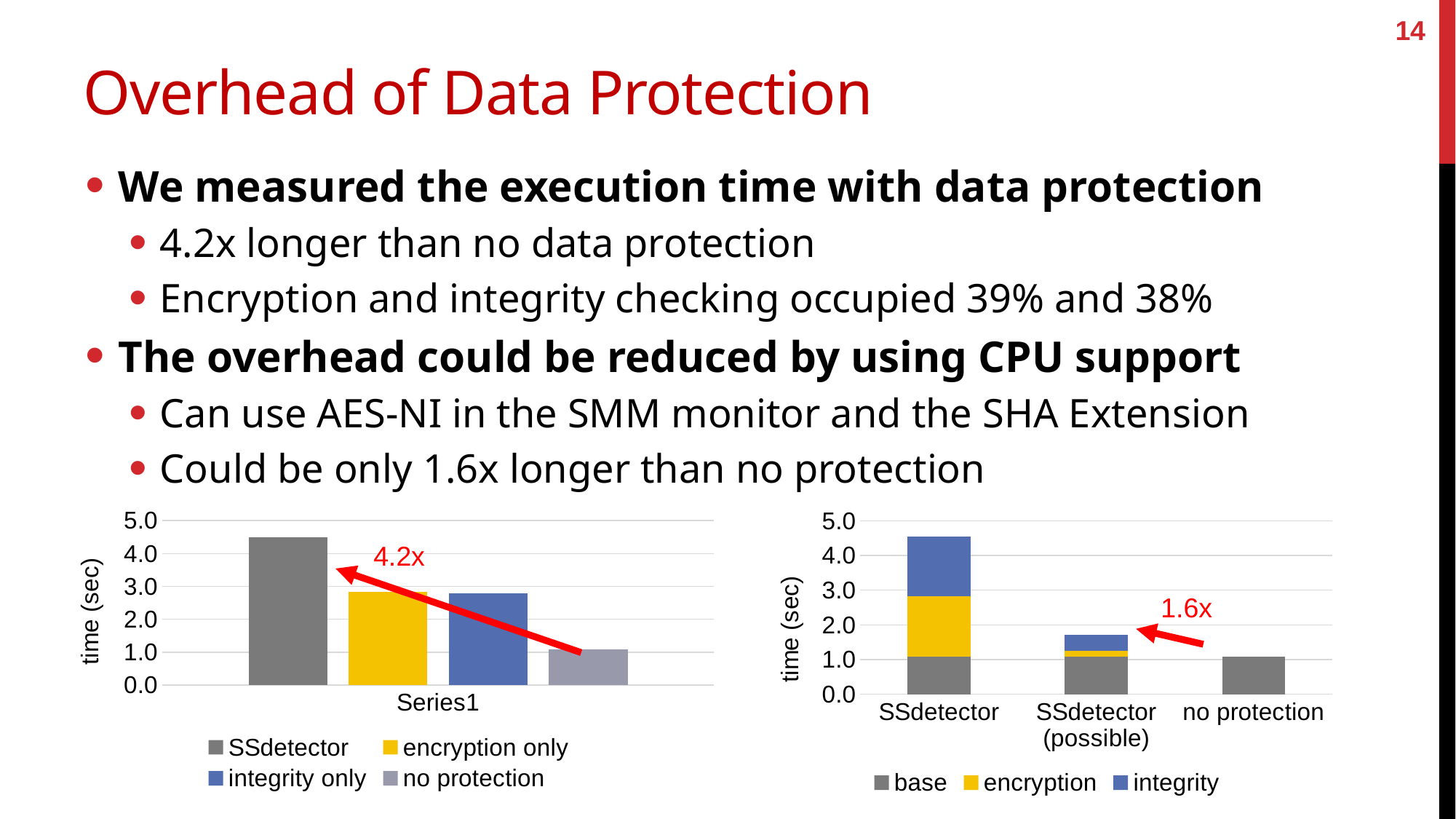
How many categories are shown on the x axis of the right chart? 3 In the left chart, which series has the shortest bar? no protection In the left chart, which series has the tallest bar? SSdetector What ratio is written in red next to the arrow on the left chart? 4.2x How many series does the legend of the left chart list? 4 In the left chart, is the value for SSdetector greater or less than 4.0? greater What kind of chart is the left chart? bar chart In the right chart, which category has the tallest stacked bar? SSdetector In the left chart, is the value for encryption only greater or less than 2.0? greater In the right chart, is the total for SSdetector (possible) greater or less than 2.0? less How many series does the legend of the right chart list? 3 In the left chart, which is larger, the bar for SSdetector or the bar for no protection? SSdetector